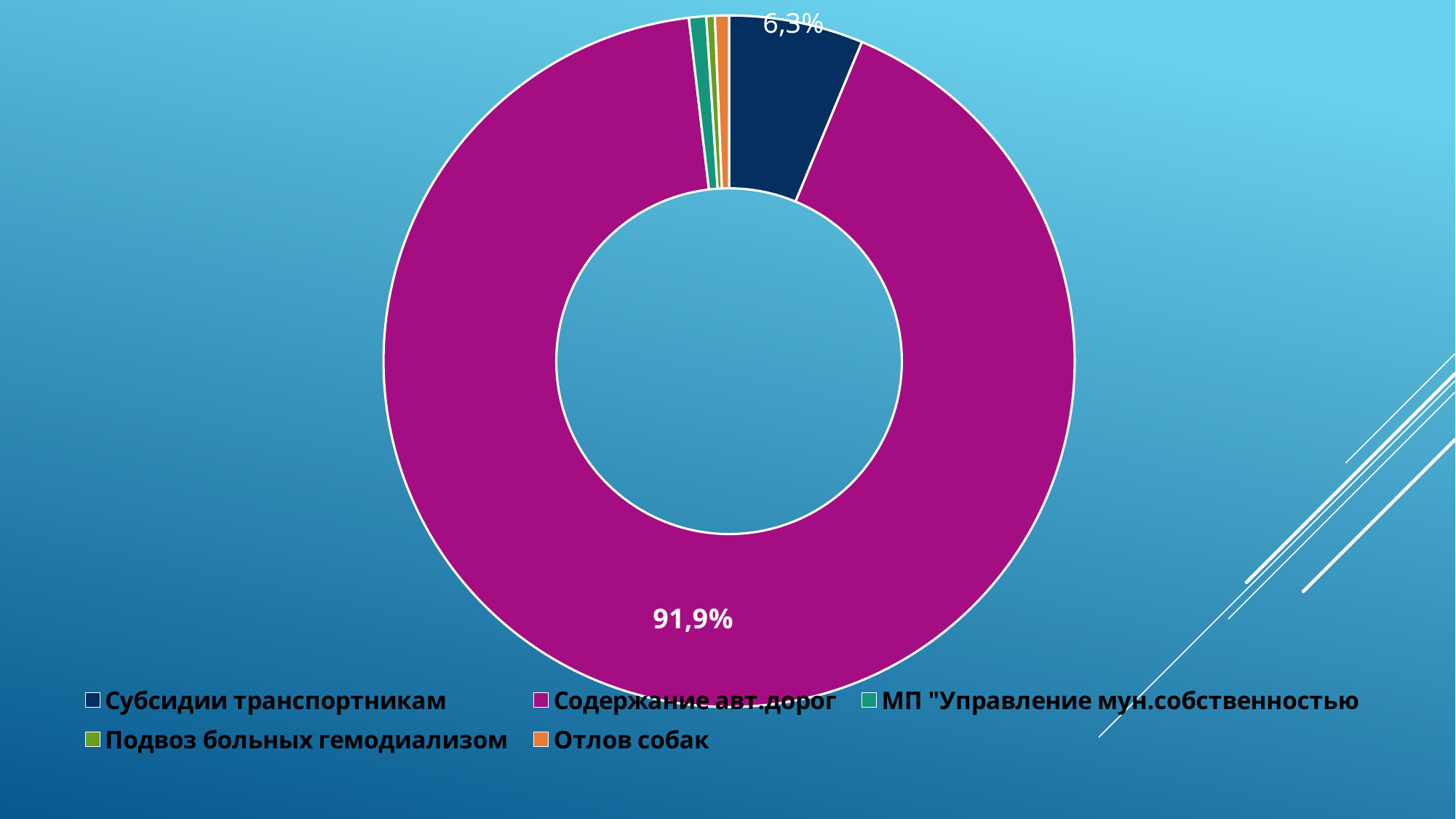
Is the share of Субсидии транспортникам greater or less than 10%? less What kind of chart is shown on the slide? doughnut chart What percentage is shown for Субсидии транспортникам? 6,3% What percentage is shown for Содержание авт.дорог? 91,9% Where is the legend placed relative to the chart? below the chart What colour is the slice for Содержание авт.дорог? magenta Is the share of Содержание авт.дорог greater or less than 50%? greater Which is larger: the share of Субсидии транспортникам or the share of Содержание авт.дорог? Содержание авт.дорог Which category has the largest share of the chart? Содержание авт.дорог How many categories does the legend list? 5 What is the difference between the shares of Содержание авт.дорог and Субсидии транспортникам? 85,6%